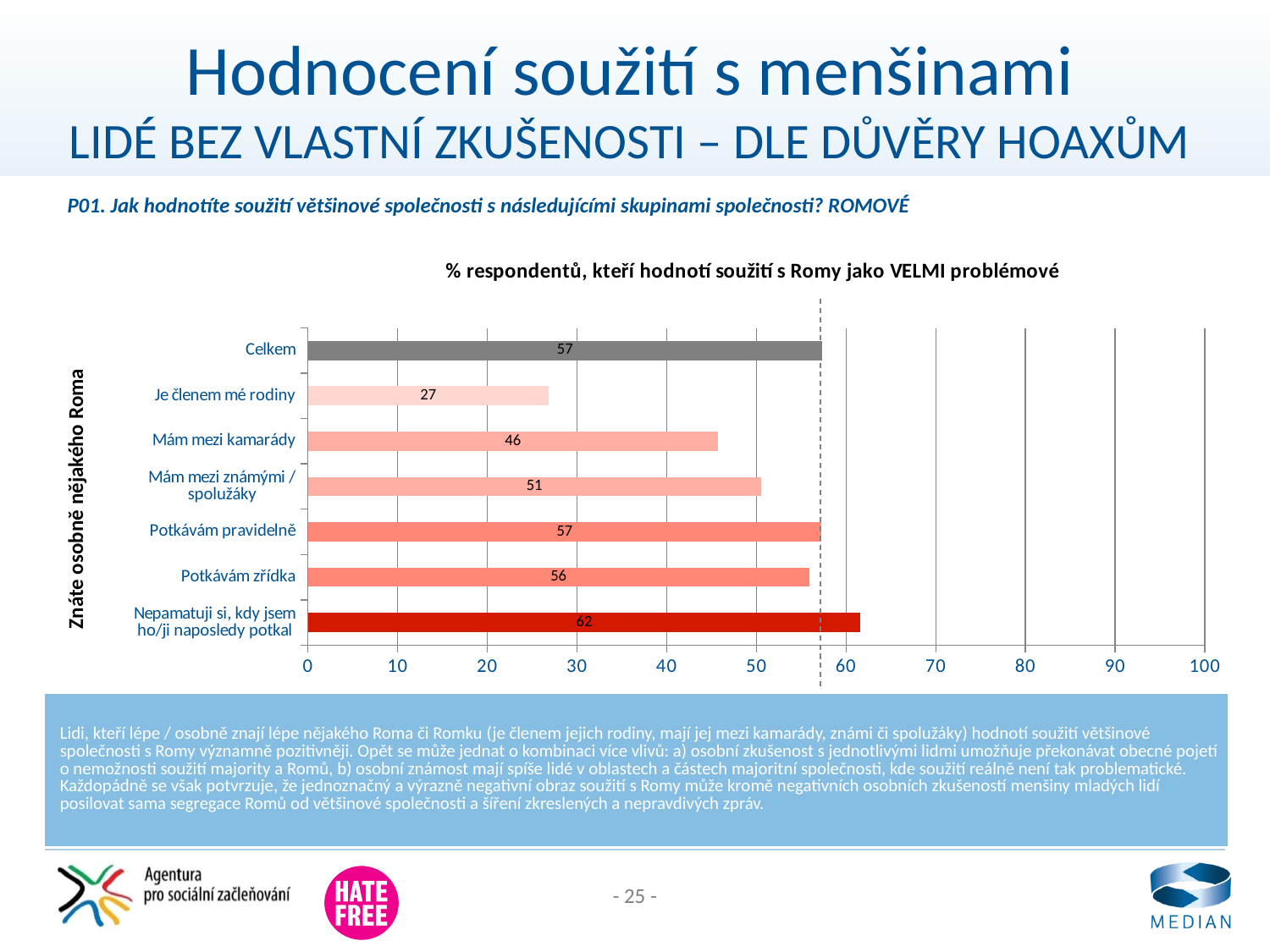
What is the value for "Celkem"? 57 What is the difference between the values for "Nepamatuji si, kdy jsem ho/ji naposledy potkal" and "Je členem mé rodiny"? 35 What kind of chart is shown on the slide? bar chart Which category has the highest value? Nepamatuji si, kdy jsem ho/ji naposledy potkal What is the value for "Mám mezi známými / spolužáky"? 51 How many categories are shown in the chart? 7 What is the value for "Potkávám zřídka"? 56 What is the value for "Je členem mé rodiny"? 27 What is the difference between the values for "Celkem" and "Mám mezi kamarády"? 11 Which is larger, the value for "Mám mezi kamarády" or the value for "Mám mezi známými / spolužáky"? Mám mezi známými / spolužáky Which category has the lowest value? Je členem mé rodiny Is the value for "Mám mezi kamarády" greater or less than 50? less